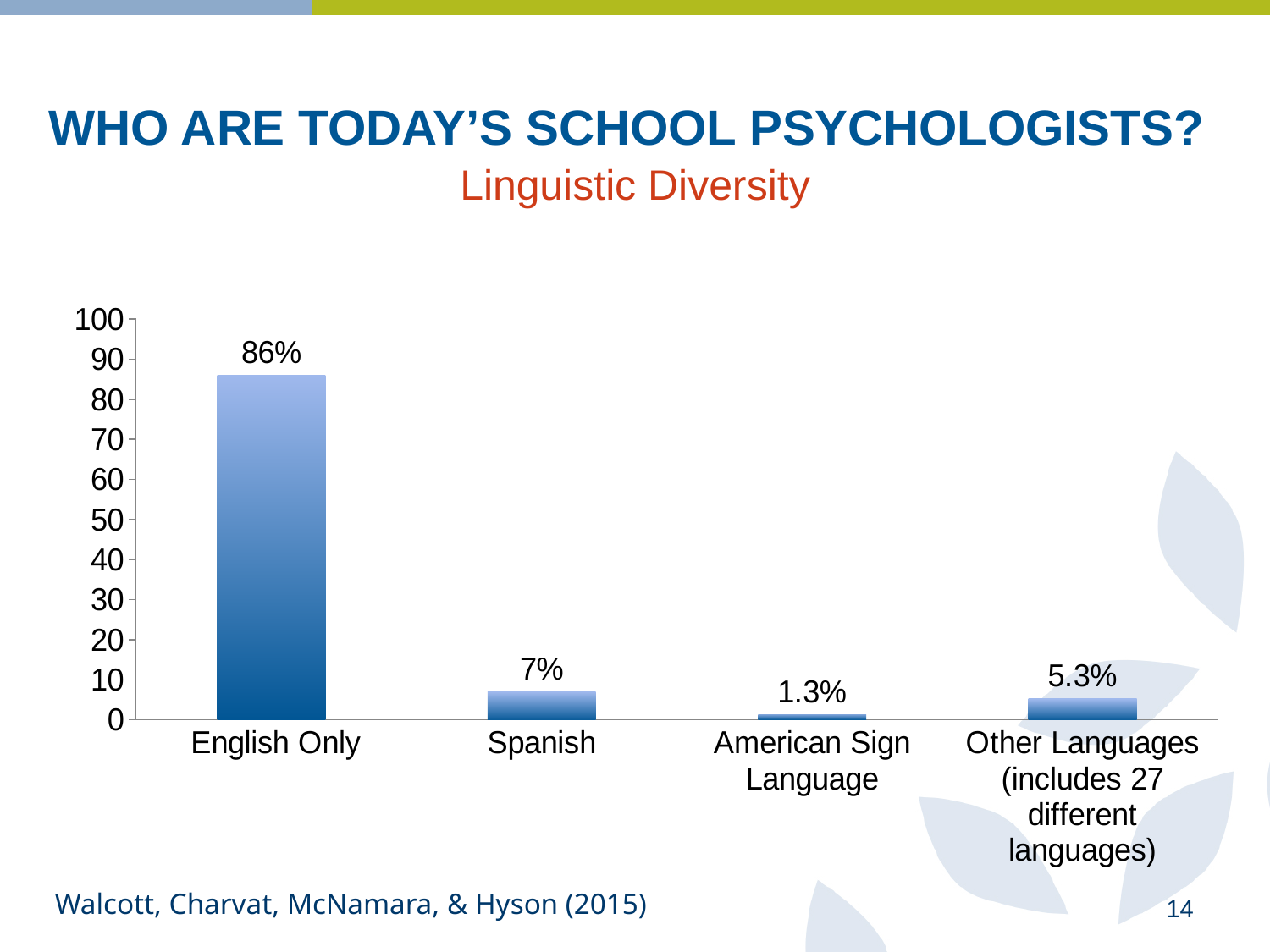
Which language category has the highest value? English Only What type of chart is shown on the slide? Bar chart What is the difference between the Other Languages and American Sign Language values? 4% How many language categories are shown in the chart? 4 Which language category has the lowest value? American Sign Language What is the value shown for Other Languages? 5.3% What is the value shown for American Sign Language? 1.3% What percentage of school psychologists are English Only speakers? 86% How many different languages does the Other Languages category include, according to its axis label? 27 What is the difference between the English Only and Spanish values? 79% What is the value shown for Spanish? 7% Which is larger, the value for Spanish or the value for Other Languages? Spanish